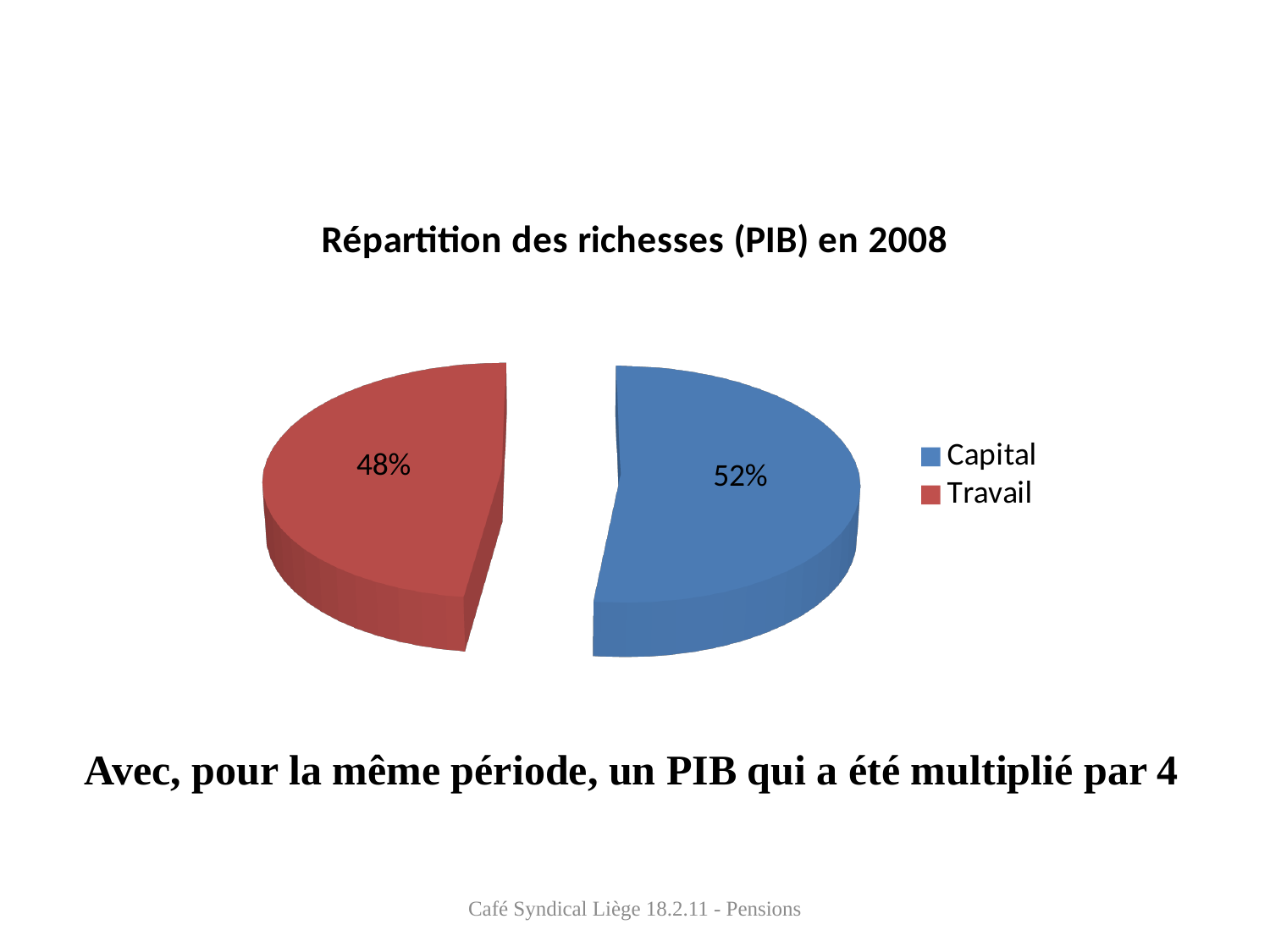
How many entries does the legend list? 2 How many slices does the pie chart have? 2 What share of the pie does Travail have? 48% What is the difference in percentage points between the Capital and Travail slices? 4 Which slice is the largest? Capital What kind of chart is shown on the slide? Pie chart What share of the pie does Capital have? 52% Which slice is the smallest? Travail What is the title of the chart? Répartition des richesses (PIB) en 2008 What colour is the Travail slice? Red Which is larger, the Capital slice or the Travail slice? Capital